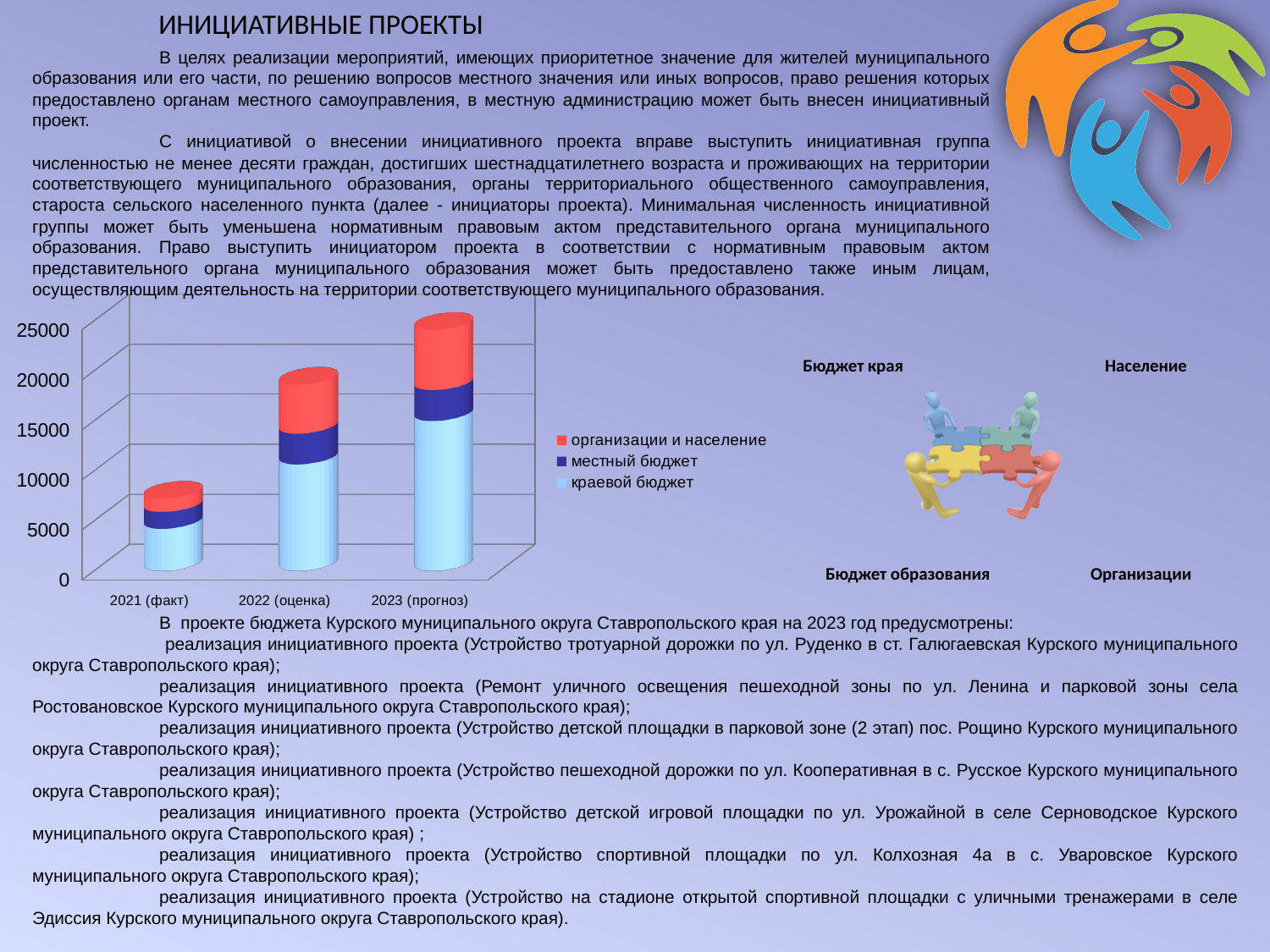
Which category has the shortest stacked bar? 2021 (факт) Is the value of краевой бюджет for 2023 (прогноз) greater or less than 10000? greater What kind of chart is shown on the slide? stacked bar chart Do the total bar heights rise or fall from 2021 (факт) to 2023 (прогноз)? rise How many series does the chart legend list? 3 Which series is shown in red in the chart legend? организации и население Is the total of the stacked bar for 2022 (оценка) greater or less than 15000? greater Is the total of the stacked bar for 2021 (факт) greater or less than 10000? less How many categories are shown on the x axis of the chart? 3 Which category has the tallest stacked bar? 2023 (прогноз) Which stacked bar is taller, 2022 (оценка) or 2021 (факт)? 2022 (оценка)